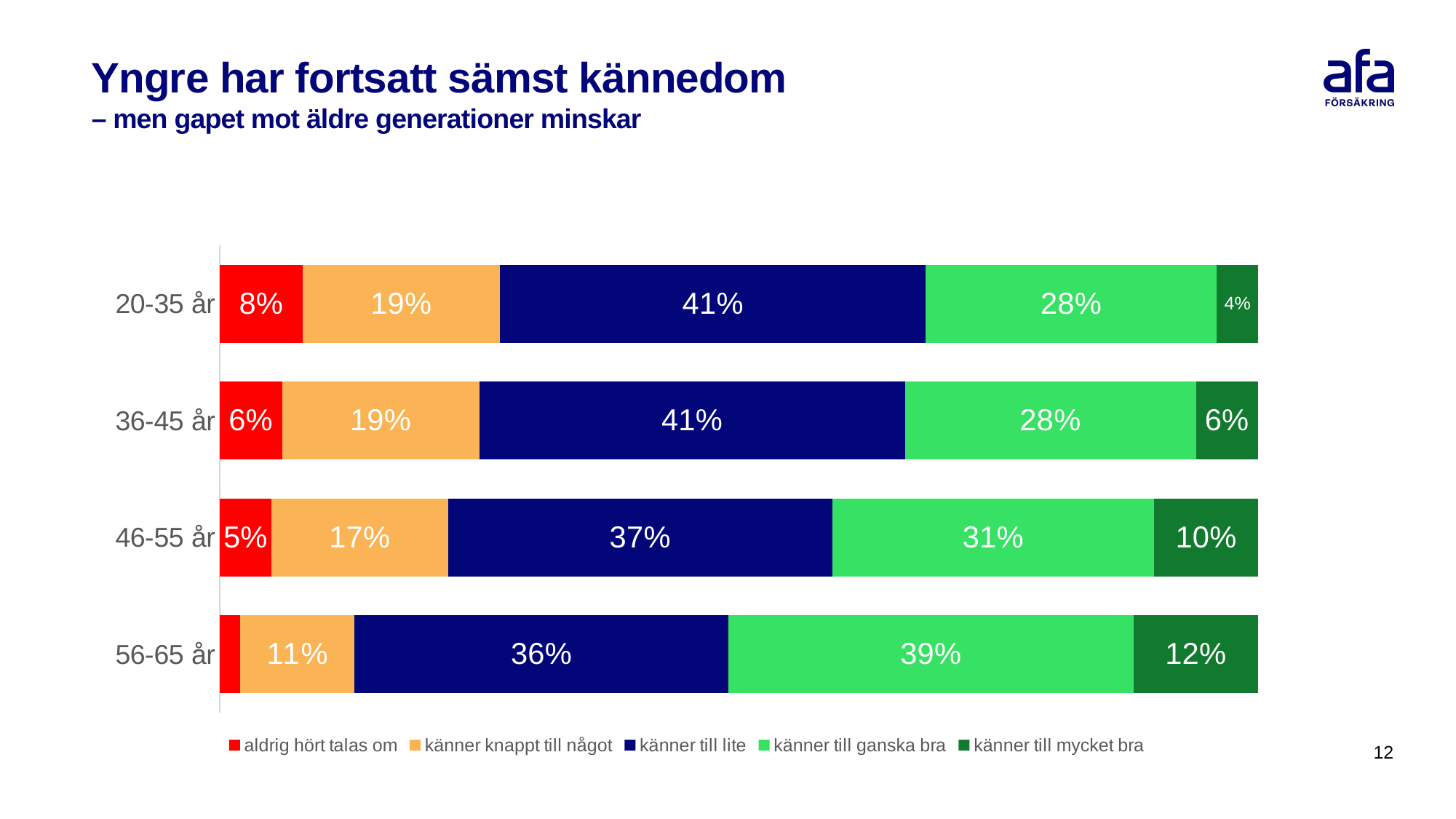
What percentage of the 20-35 år group answered "känner till lite"? 41% What percentage of the 56-65 år group answered "känner till ganska bra"? 39% What is the value for "aldrig hört talas om" in the 36-45 år group? 6% How many series does the legend list? 5 Which age group has the lowest share for "känner till mycket bra"? 20-35 år What type of chart is shown on the slide? Stacked bar chart Which group has the larger share for "känner knappt till något": 20-35 år or 56-65 år? 20-35 år What is the value for "känner till mycket bra" in the 46-55 år group? 10% Which age group has the highest share for "känner till mycket bra"? 56-65 år How many percentage points higher is "känner till ganska bra" for 56-65 år than for 20-35 år? 11 percentage points How many age groups are shown in the chart? 4 Which age group has the highest share for "aldrig hört talas om"? 20-35 år